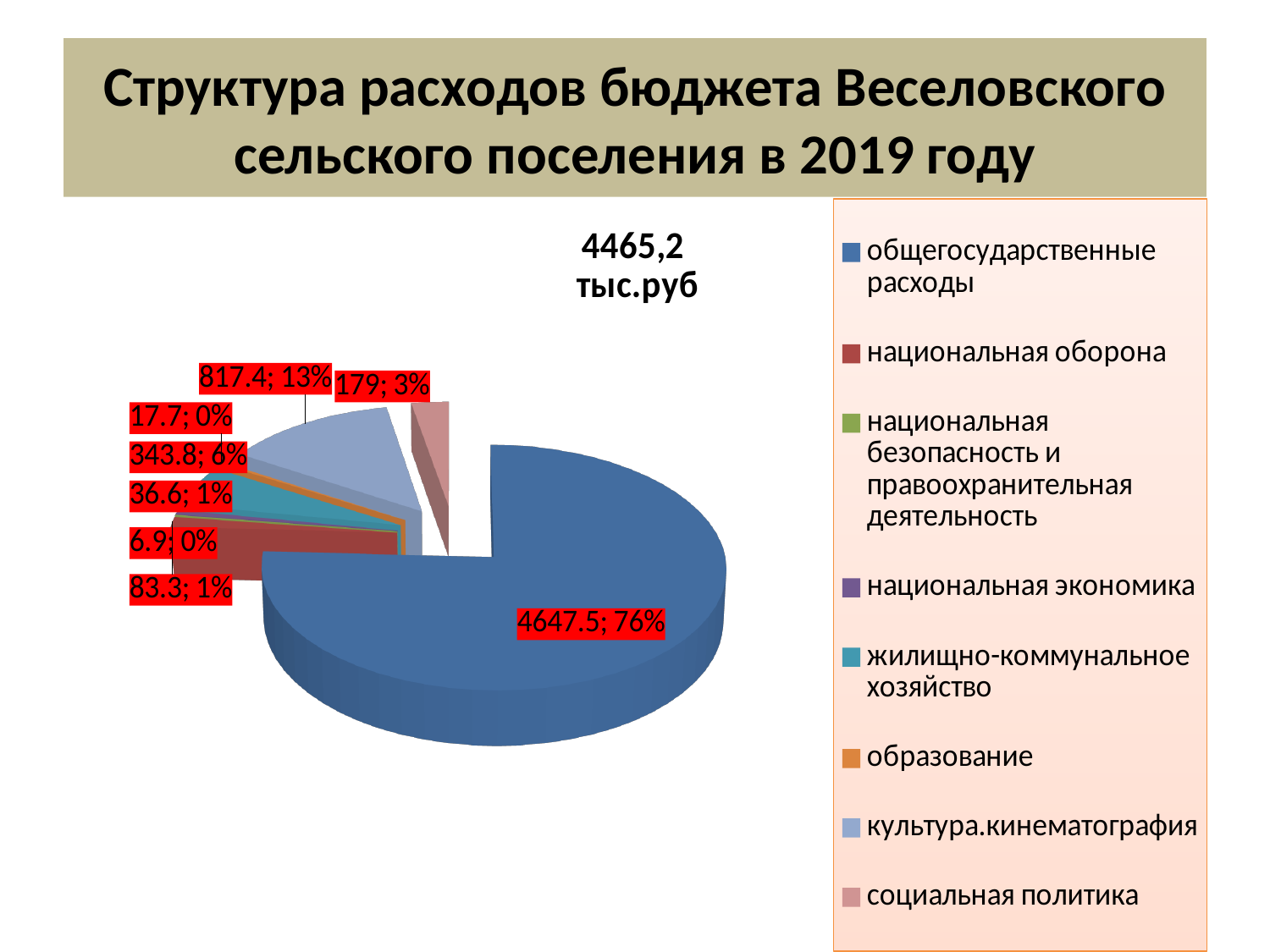
What is the value shown for социальная политика? 179 How many entries does the legend list? 8 Which category has the smallest value on the chart? национальная безопасность и правоохранительная деятельность What is the value shown for культура.кинематография? 817.4 What kind of chart is shown on the slide? pie chart Which is larger, the value for культура.кинематография or the value for жилищно-коммунальное хозяйство? культура.кинематография What share of the pie does жилищно-коммунальное хозяйство take? 6% What share of the pie does общегосударственные расходы take? 76% What is the difference between the values for культура.кинематография and социальная политика? 638.4 Which category has the largest slice of the pie? общегосударственные расходы What title is shown above the pie chart? 4465,2 тыс.руб What is the value shown for общегосударственные расходы? 4647.5